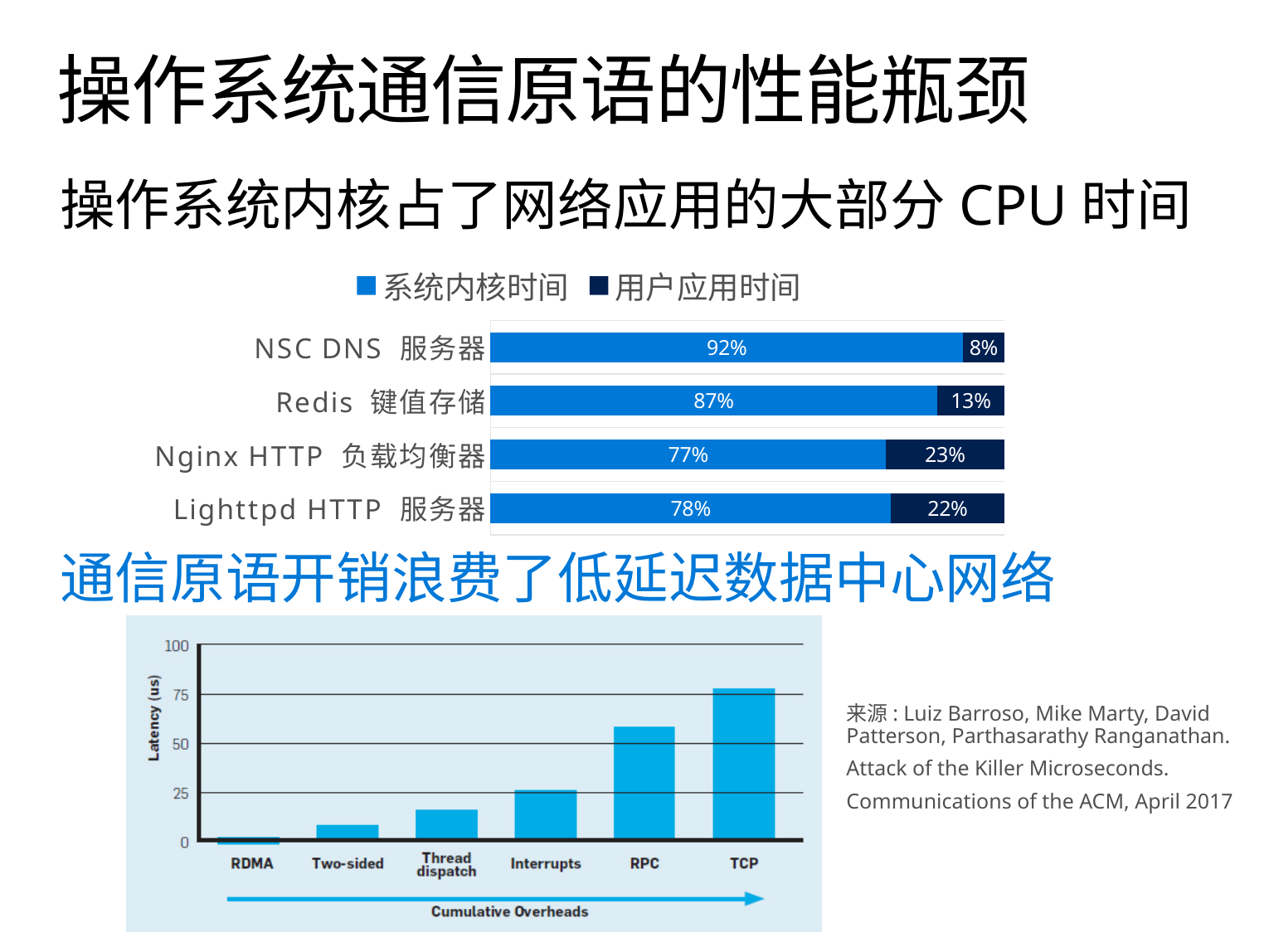
In the top chart, what is the total of the stacked bar for Redis 键值存储? 100% In the bottom chart, is the value for RPC greater or less than 50? greater In the top chart, which category has the lowest 用户应用时间? NSC DNS 服务器 In the bottom chart, which category has the lowest latency? RDMA In the top chart, how many categories are shown? 4 In the bottom chart, which category has the highest latency? TCP In the bottom chart, do the latency values rise or fall from RDMA to TCP along the x axis? rise In the top chart, what is the 系统内核时间 value for NSC DNS 服务器? 92% In the top chart, how many series does the legend list? 2 In the top chart, which category has the highest 系统内核时间? NSC DNS 服务器 In the top chart, what is the difference between the 系统内核时间 of Redis 键值存储 and Lighttpd HTTP 服务器? 9% In the top chart, what is the 用户应用时间 value for Nginx HTTP 负载均衡器? 23%